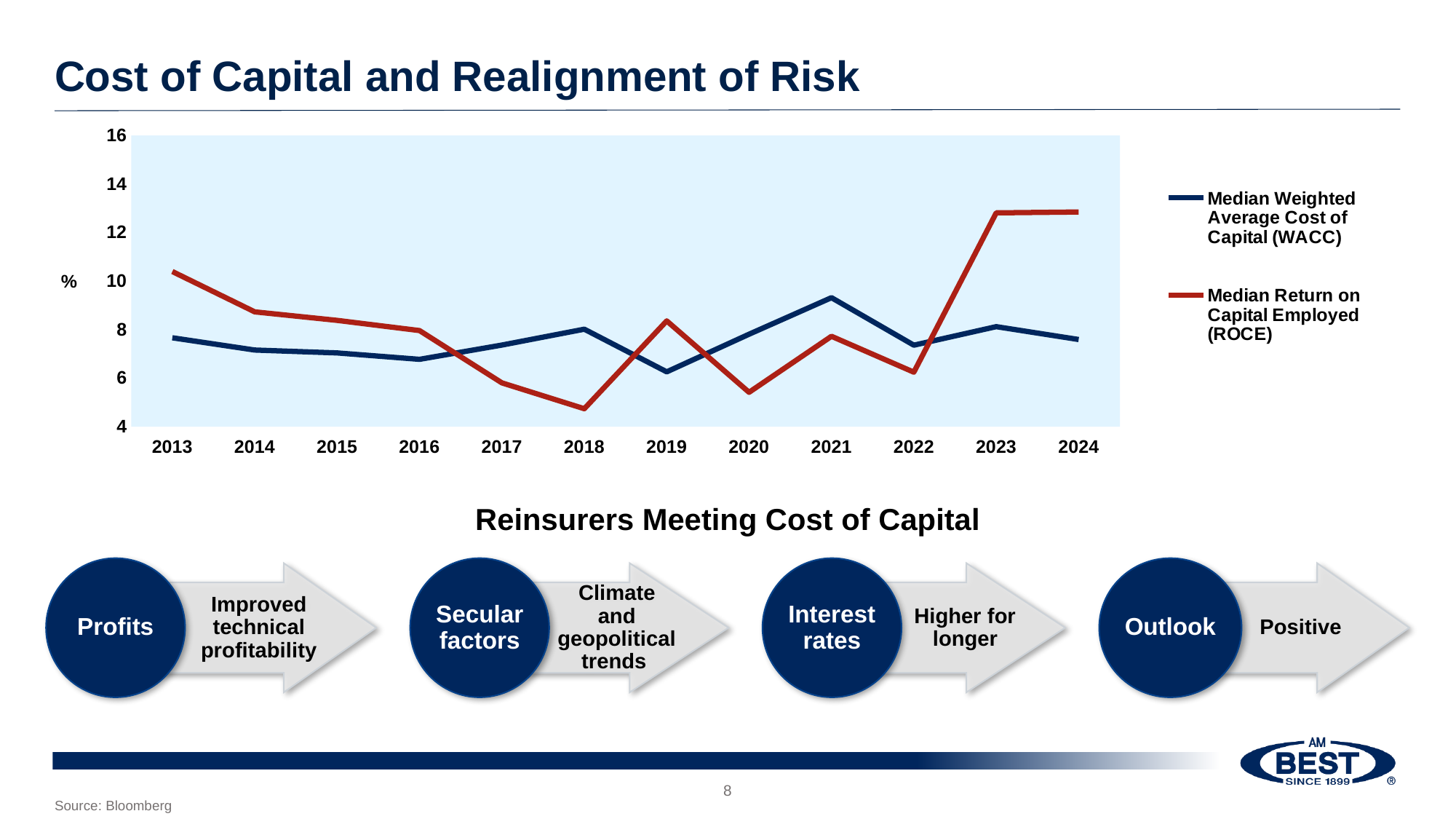
Is the Median Weighted Average Cost of Capital (WACC) value for 2021 greater or less than 8? greater In 2018, which is larger: the Median WACC or the Median ROCE? Median WACC Does the Median Return on Capital Employed (ROCE) rise or fall from 2013 to 2018? fall What kind of chart is shown on the slide? line chart How many series does the chart's legend list? 2 In which year is the Median Weighted Average Cost of Capital (WACC) highest? 2021 Is the Median Return on Capital Employed (ROCE) value for 2018 greater or less than 6? less Is the Median Return on Capital Employed (ROCE) value for 2023 greater or less than 12? greater How many years are plotted along the x axis of the chart? 12 In which year is the Median Weighted Average Cost of Capital (WACC) lowest? 2019 In 2024, which is larger: the Median WACC or the Median ROCE? Median ROCE In which year is the Median Return on Capital Employed (ROCE) lowest? 2018